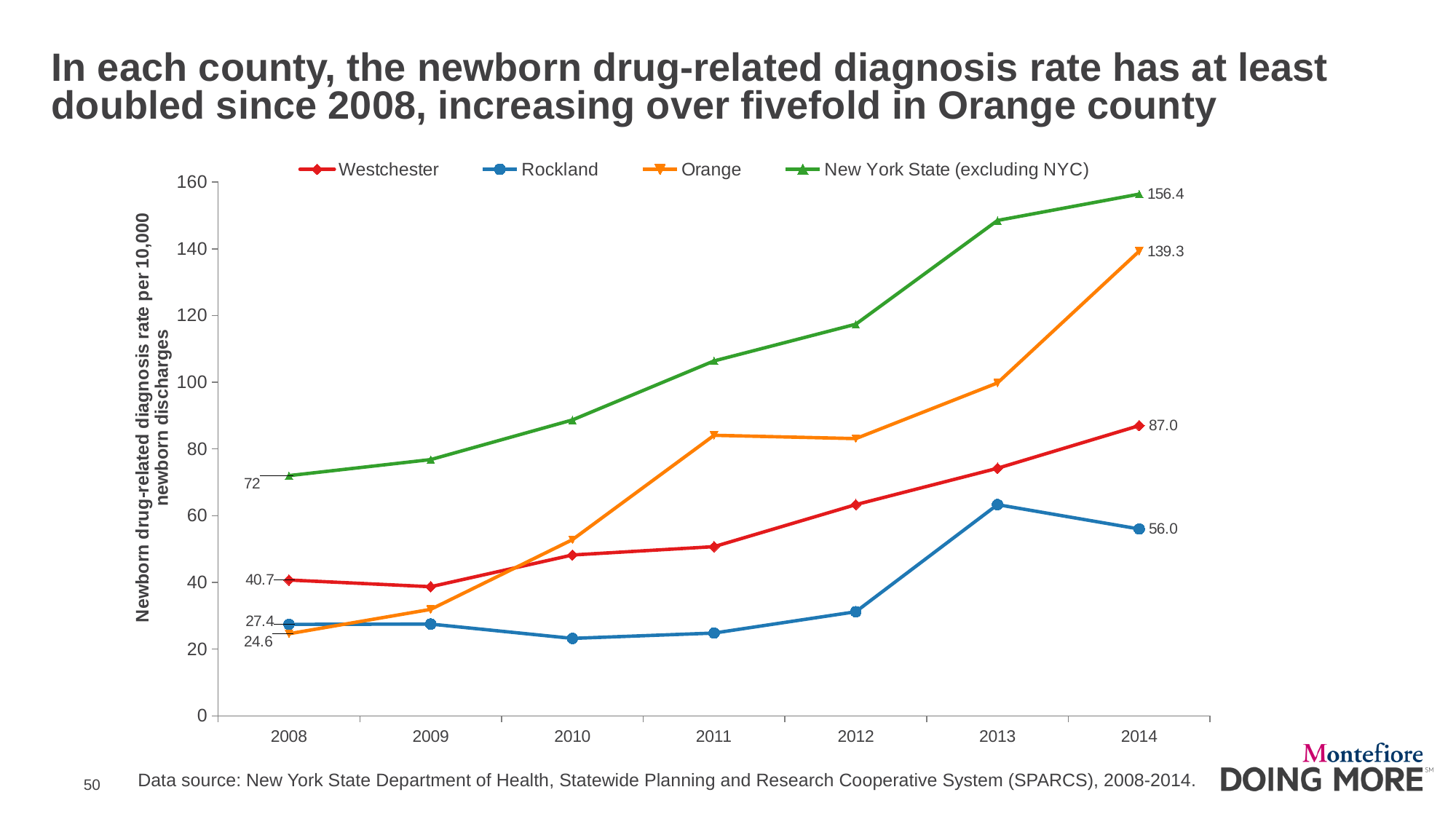
What is the value for New York State (excluding NYC) in 2014? 156.4 Is the value for Rockland in 2013 greater or less than 60? greater How many years are shown on the x axis? 7 What is the newborn drug-related diagnosis rate for Westchester in 2008? 40.7 Does the New York State (excluding NYC) line rise or fall from 2008 to 2014? rise What type of chart is shown on the slide? line chart What is the newborn drug-related diagnosis rate for Orange county in 2014? 139.3 Which series has the lowest value in 2008? Orange Which series has the highest value in 2014? New York State (excluding NYC) What is the value for Rockland in 2008? 27.4 How many series does the legend list? 4 By how much did the Orange county rate increase from 2008 to 2014? 114.7